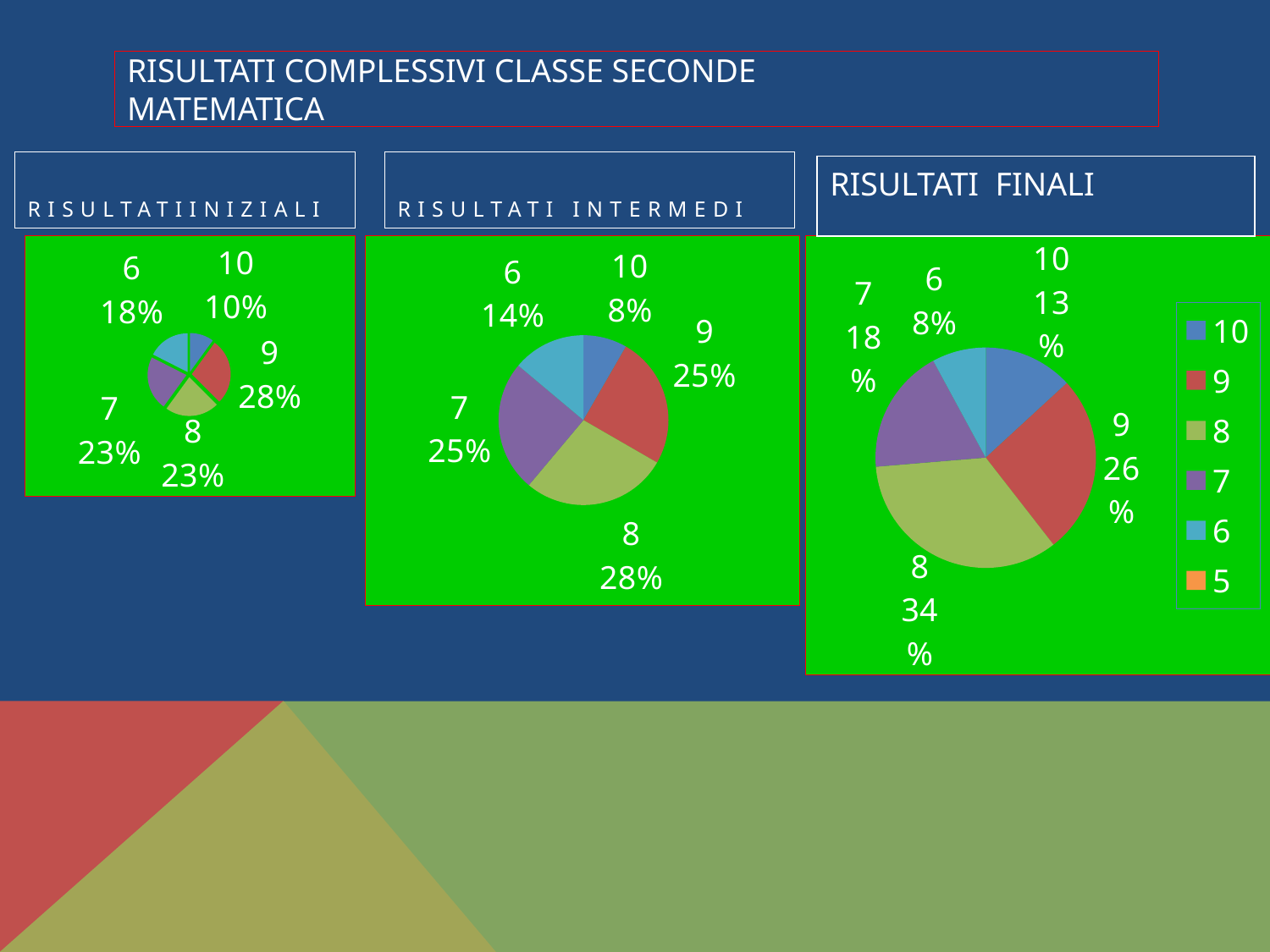
In the RISULTATI FINALI chart, which is larger, the slice for grade 9 or the slice for grade 7? 9 In the RISULTATI INIZIALI chart, what percentage is shown for grade 10? 10% What type of chart is used in the RISULTATI INTERMEDI panel? Pie chart How many entries does the legend of the RISULTATI FINALI chart list? 6 In the RISULTATI INIZIALI chart, which grade has the largest slice? 9 In the RISULTATI INIZIALI chart, what share of the pie does grade 9 have? 28% In the RISULTATI INTERMEDI chart, what is the difference in percentage points between grade 8 and grade 6? 14 In the RISULTATI FINALI chart, which grade has the largest slice? 8 In the RISULTATI INTERMEDI chart, which grade has the smallest slice? 10 In the RISULTATI FINALI chart, what is the difference in percentage points between grade 9 and grade 10? 13 In the RISULTATI FINALI chart, what percentage is shown for grade 8? 34% In the RISULTATI INTERMEDI chart, what percentage is shown for grade 8? 28%